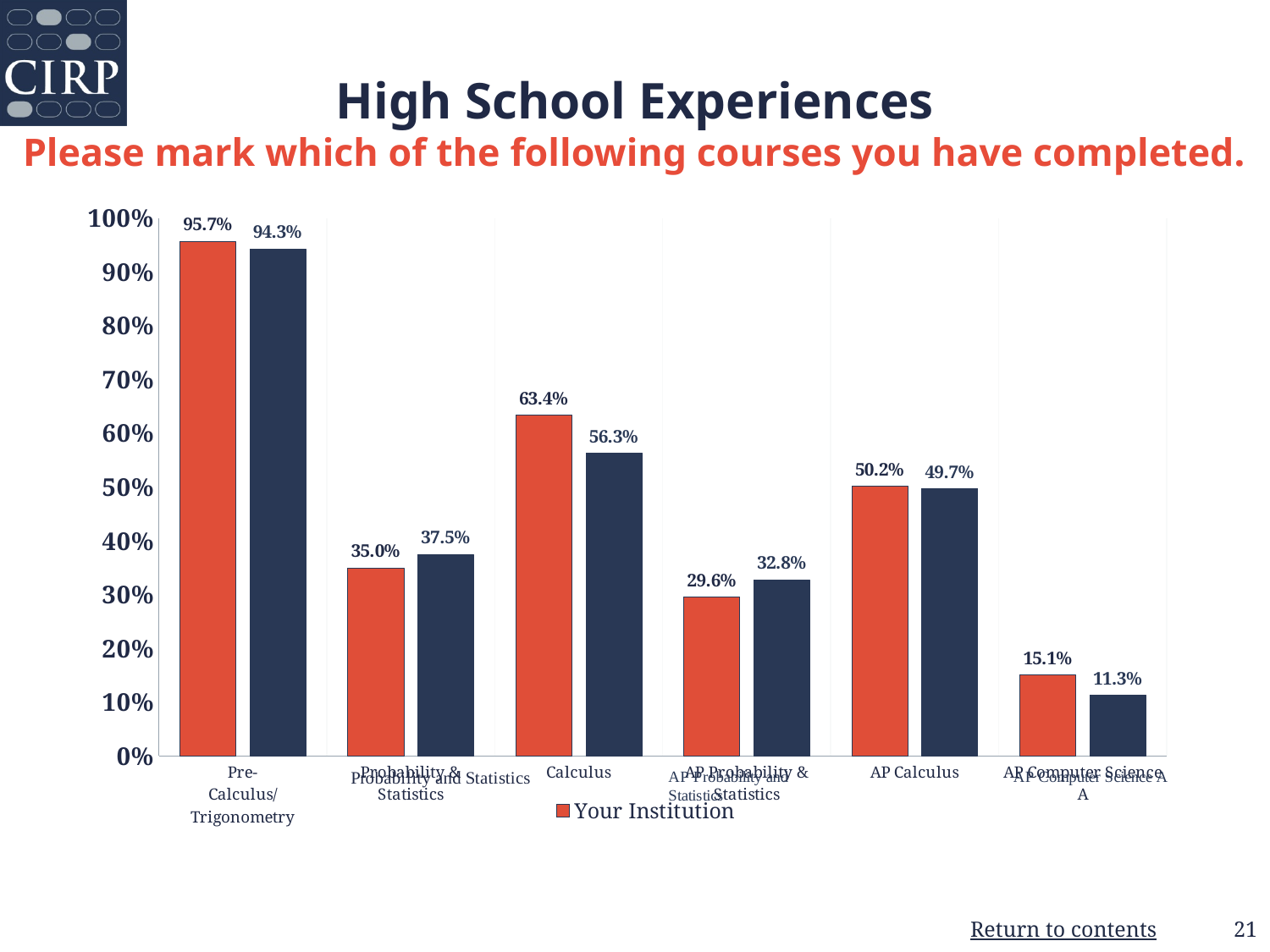
What is the difference between the Your Institution value and the dark blue bar value for Calculus? 7.1% Which course has the highest value for Your Institution? Pre-Calculus/Trigonometry What is the value of the dark blue bar for AP Computer Science A? 11.3% Is the Your Institution value for AP Calculus greater or less than 40%? greater Which course has the lowest value for the dark blue bars? AP Computer Science A What kind of chart is shown on the slide? bar chart What is the total of the Your Institution values for AP Calculus and AP Computer Science A? 65.3% How many courses are shown on the x axis? 6 For Probability & Statistics, which is larger: the Your Institution bar or the dark blue bar? the dark blue bar What is the value for Your Institution for Calculus? 63.4% What is the value for Your Institution for AP Probability & Statistics? 29.6% What colour are the Your Institution bars? orange